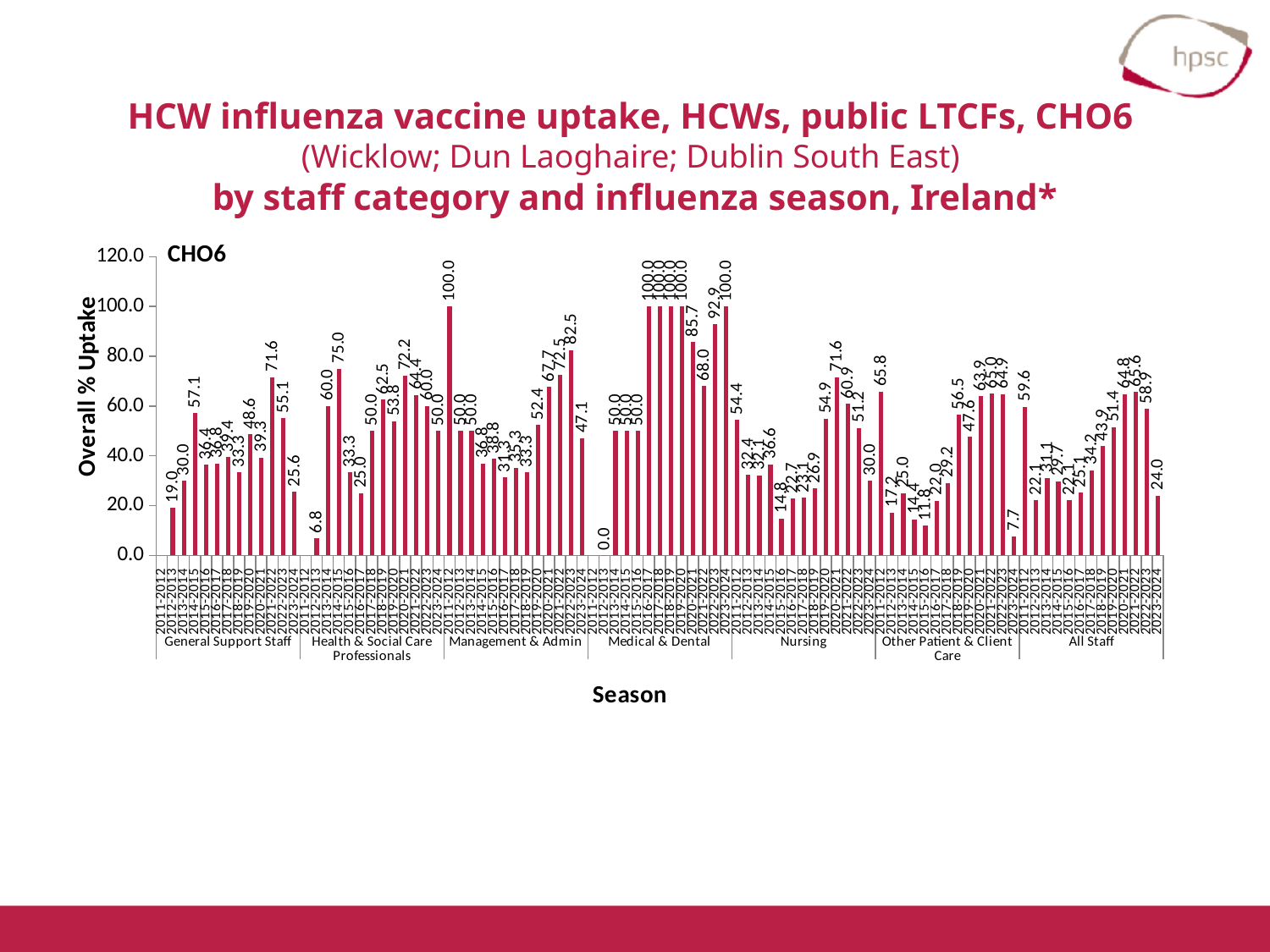
What is the lowest overall % uptake value shown for Nursing? 14.8 What is the overall % uptake for Management & Admin in the 2011-2012 season? 100.0 By how much did the All Staff overall % uptake fall from 2011-2012 to 2023-2024? 35.6 What is the All Staff overall % uptake for the 2023-2024 season? 24.0 What type of chart is shown on the slide? Bar chart What is the All Staff overall % uptake for the 2011-2012 season? 59.6 What is the overall % uptake for Other Patient & Client Care in the 2023-2024 season? 7.7 In the 2011-2012 season, which is higher: the Nursing uptake or the All Staff uptake? All Staff What is the overall % uptake for Nursing in the 2023-2024 season? 30.0 How many staff category groups are shown along the x axis? 7 What is the highest overall % uptake value shown for Health & Social Care Professionals? 75.0